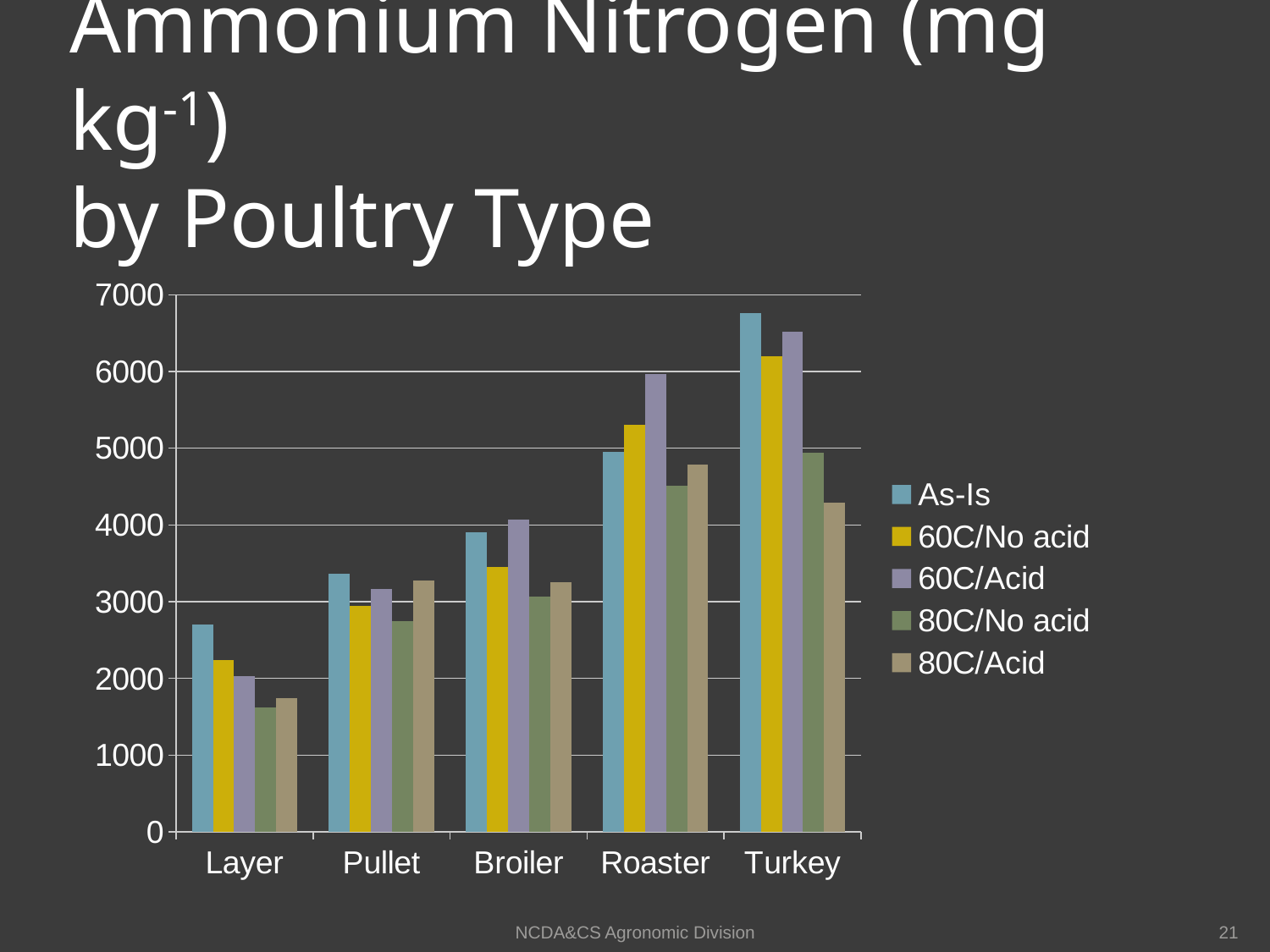
What is the first entry listed in the legend? As-Is Is the 80C/No acid value for Layer greater or less than 2000? less Is the 60C/Acid value for Roaster greater or less than 5000? greater What kind of chart is shown on the slide? bar chart How many series does the legend list? 5 For Roaster, which is larger: the As-Is value or the 60C/Acid value? 60C/Acid Is the As-Is value for Turkey greater or less than 6000? greater For Turkey, which is larger: the As-Is value or the 80C/Acid value? As-Is How many poultry types are shown on the x axis? 5 Do the As-Is values rise or fall moving from Layer to Turkey along the x axis? rise Which poultry type has the highest As-Is ammonium nitrogen value? Turkey Which poultry type has the lowest As-Is ammonium nitrogen value? Layer